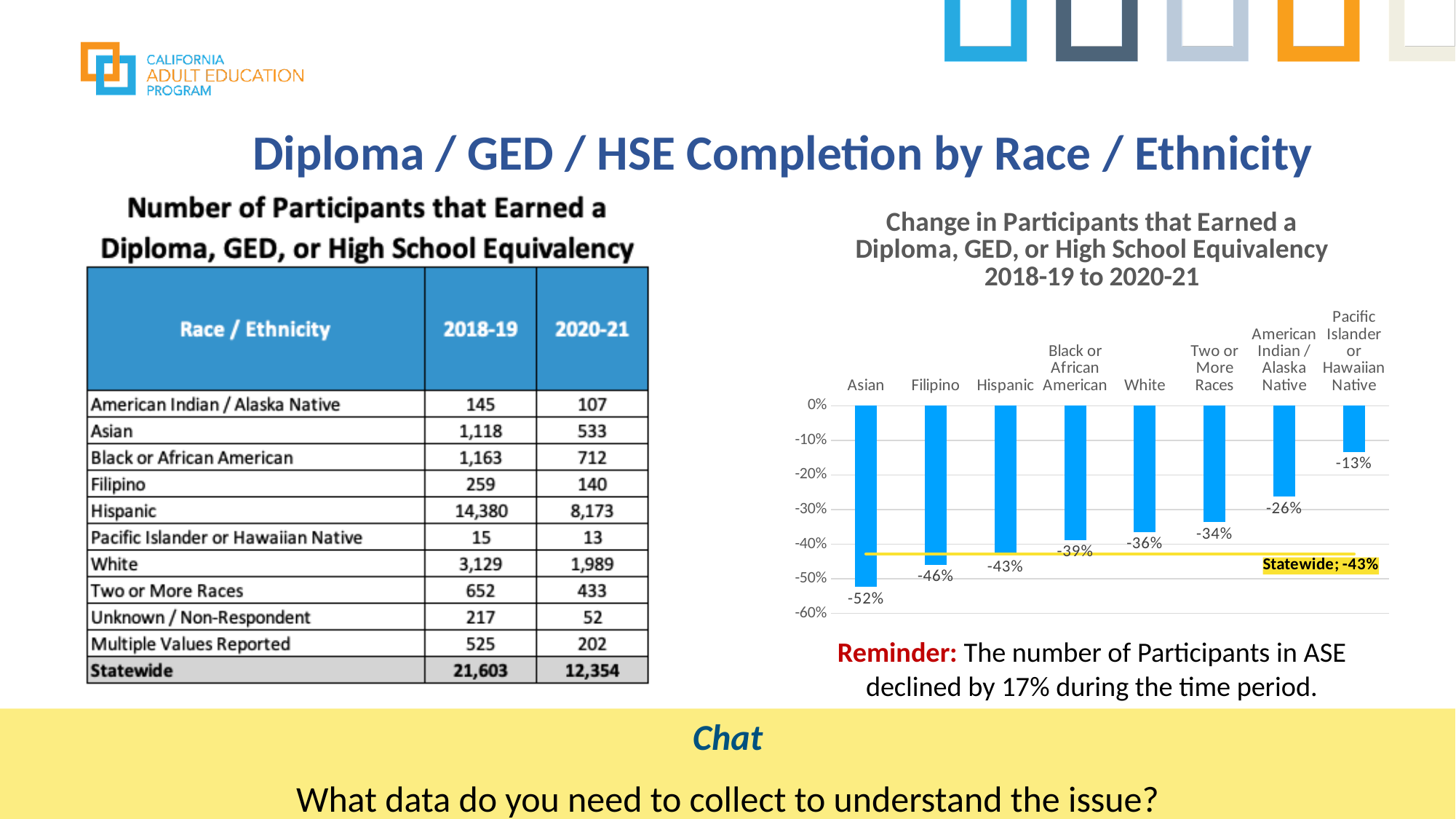
What is the change in participants for Pacific Islander or Hawaiian Native in the chart? -13% Which shows a larger decline, Hispanic or Two or More Races? Hispanic What is the change in participants for Asian in the chart? -52% What statewide change value is marked by the horizontal line on the chart? -43% What is the change in participants for American Indian / Alaska Native in the chart? -26% Do the bar values rise or fall moving from left to right along the x axis? rise How many race/ethnicity categories are plotted in the chart? 8 Which race/ethnicity shows the largest decline in the chart? Asian What is the difference in percentage points between the change for Asian and the change for Filipino? 6 percentage points What is the change in participants for White in the chart? -36% Which race/ethnicity shows the smallest decline in the chart? Pacific Islander or Hawaiian Native What kind of chart is shown on the slide? bar chart